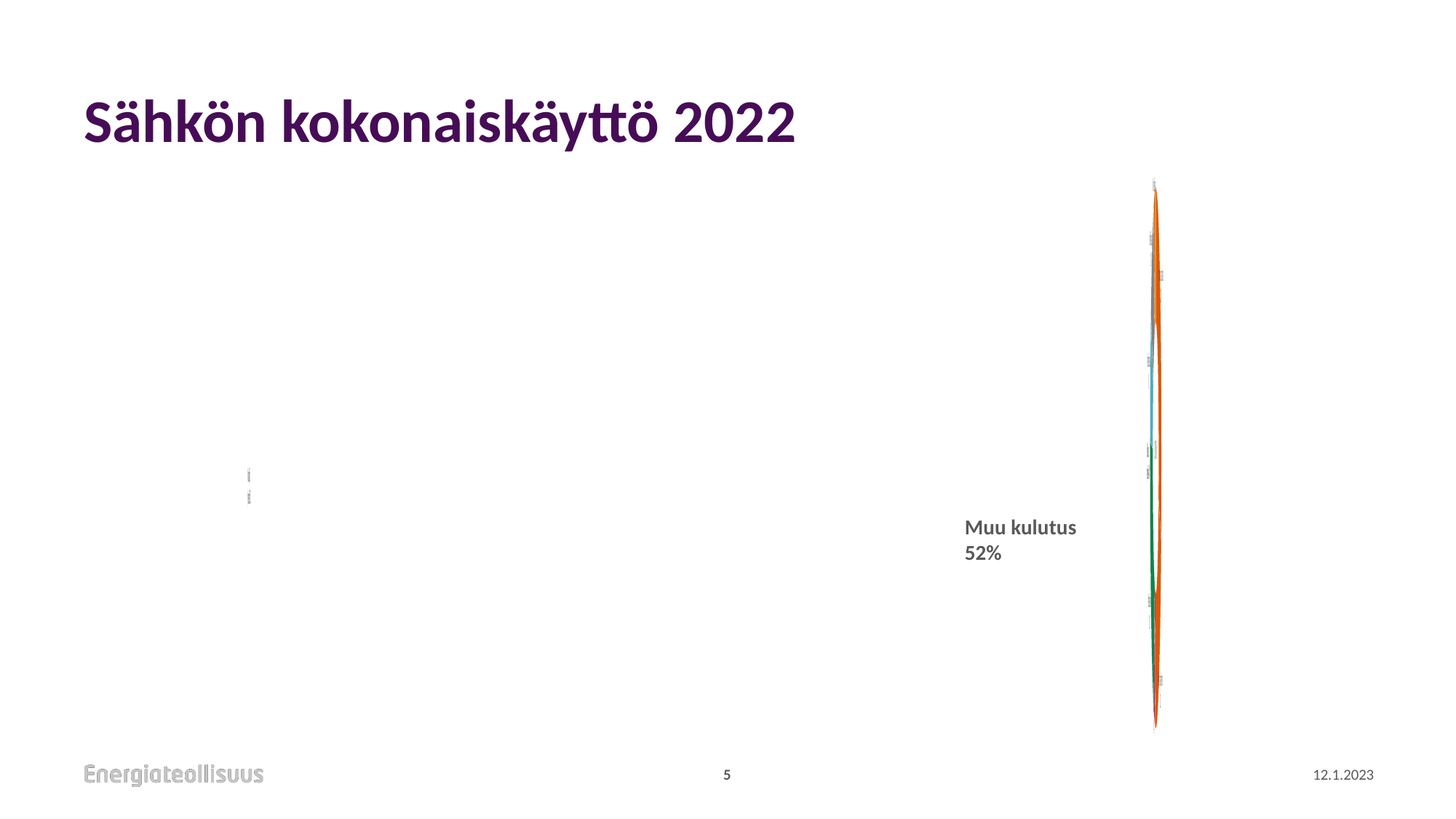
Is the share for Muu kulutus greater or less than 50%? greater Which year does the chart's data refer to, according to the slide title? 2022 What is the title of the slide containing the chart? Sähkön kokonaiskäyttö 2022 What share of the pie does Muu kulutus account for? 52%